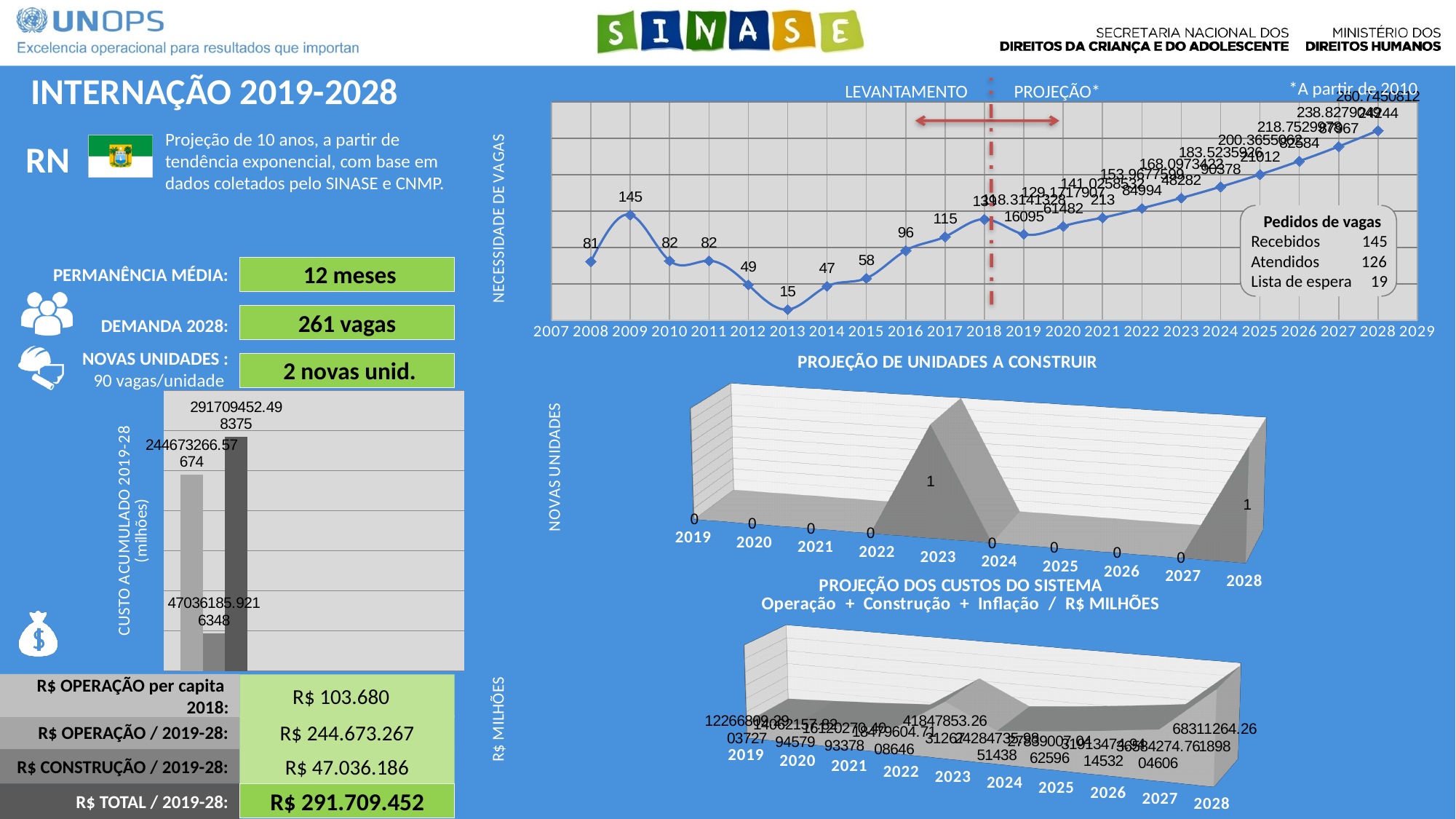
In the PROJEÇÃO DE UNIDADES A CONSTRUIR chart, what is the value for 2023? 1 In the NECESSIDADE DE VAGAS line chart, what is the difference between the 2009 value and the 2008 value? 64 In the PROJEÇÃO DE UNIDADES A CONSTRUIR chart, what is the value for 2028? 1 In the NECESSIDADE DE VAGAS line chart, which year has the larger value, 2016 or 2017? 2017 What kind of chart is the NECESSIDADE DE VAGAS chart at the top right? line chart How many years are shown on the x axis of the PROJEÇÃO DE UNIDADES A CONSTRUIR chart? 10 In the NECESSIDADE DE VAGAS line chart, what is the value for 2012? 49 What is the title of the chart at the bottom right of the slide? PROJEÇÃO DOS CUSTOS DO SISTEMA In the NECESSIDADE DE VAGAS line chart, which year has the lowest value? 2013 In the NECESSIDADE DE VAGAS line chart, what is the value for 2013? 15 In the NECESSIDADE DE VAGAS line chart, what is the value for 2009? 145 In the NECESSIDADE DE VAGAS line chart, do the values rise or fall from 2019 to 2028? rise